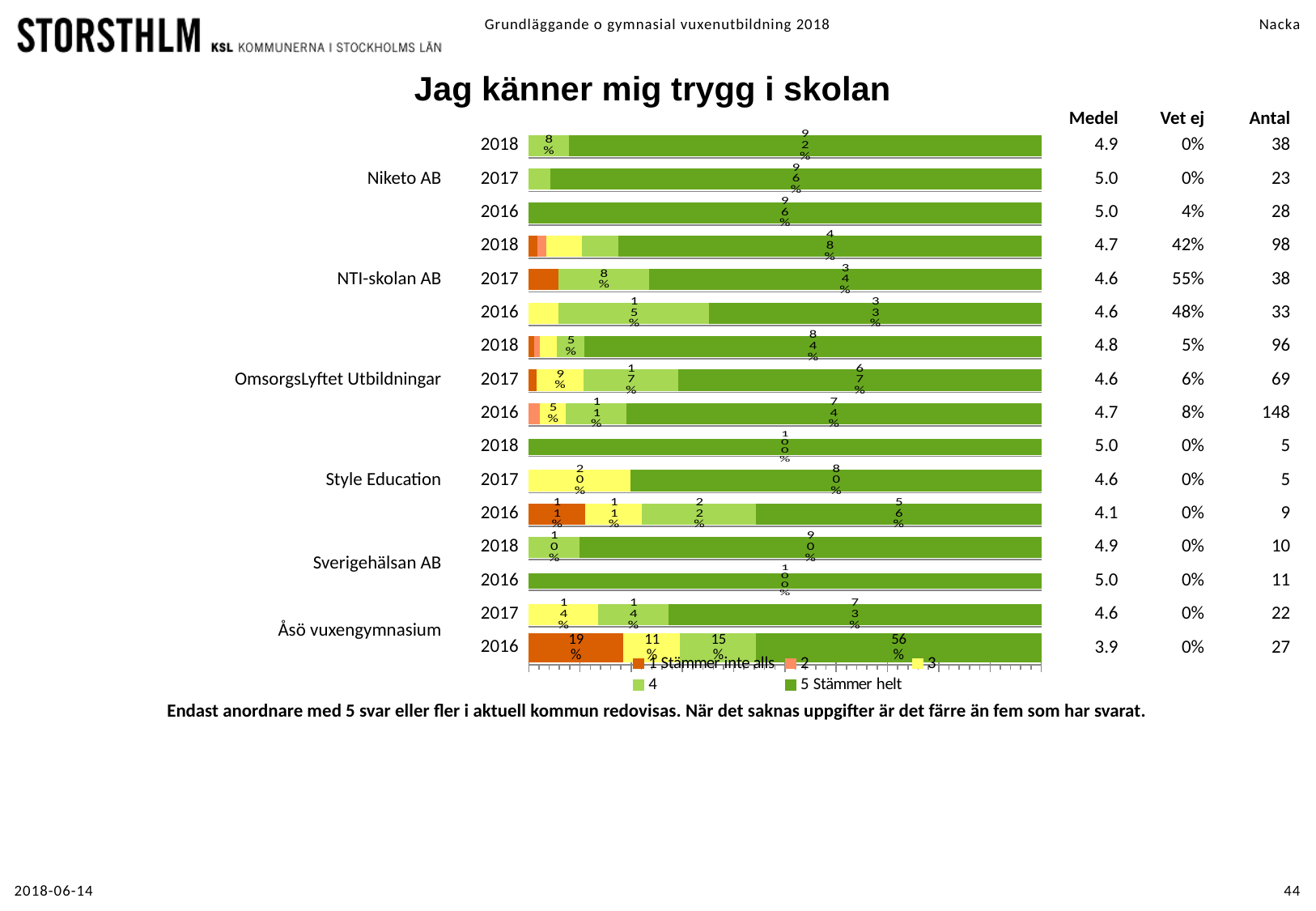
How many series does the legend list? 5 How many bars (provider-year rows) are shown in the chart? 16 What is the Antal (number of respondents) shown for OmsorgsLyftet Utbildningar in 2016? 148 What kind of chart is shown on the slide? bar chart For Åsö vuxengymnasium 2016, which is larger: the share answering '3' or the share answering '4'? 4 What percentage of Niketo AB respondents in 2018 answered '5 Stämmer helt'? 92% What is the title of the chart? Jag känner mig trygg i skolan What percentage of Style Education respondents in 2017 answered '3'? 20% What percentage of Sverigehälsan AB respondents in 2018 answered '5 Stämmer helt'? 90% What percentage of Åsö vuxengymnasium respondents in 2016 answered '1 Stämmer inte alls'? 19% For Åsö vuxengymnasium 2016, what is the difference in percentage points between '5 Stämmer helt' and '1 Stämmer inte alls'? 37 percentage points What percentage of Åsö vuxengymnasium respondents in 2016 answered '5 Stämmer helt'? 56%